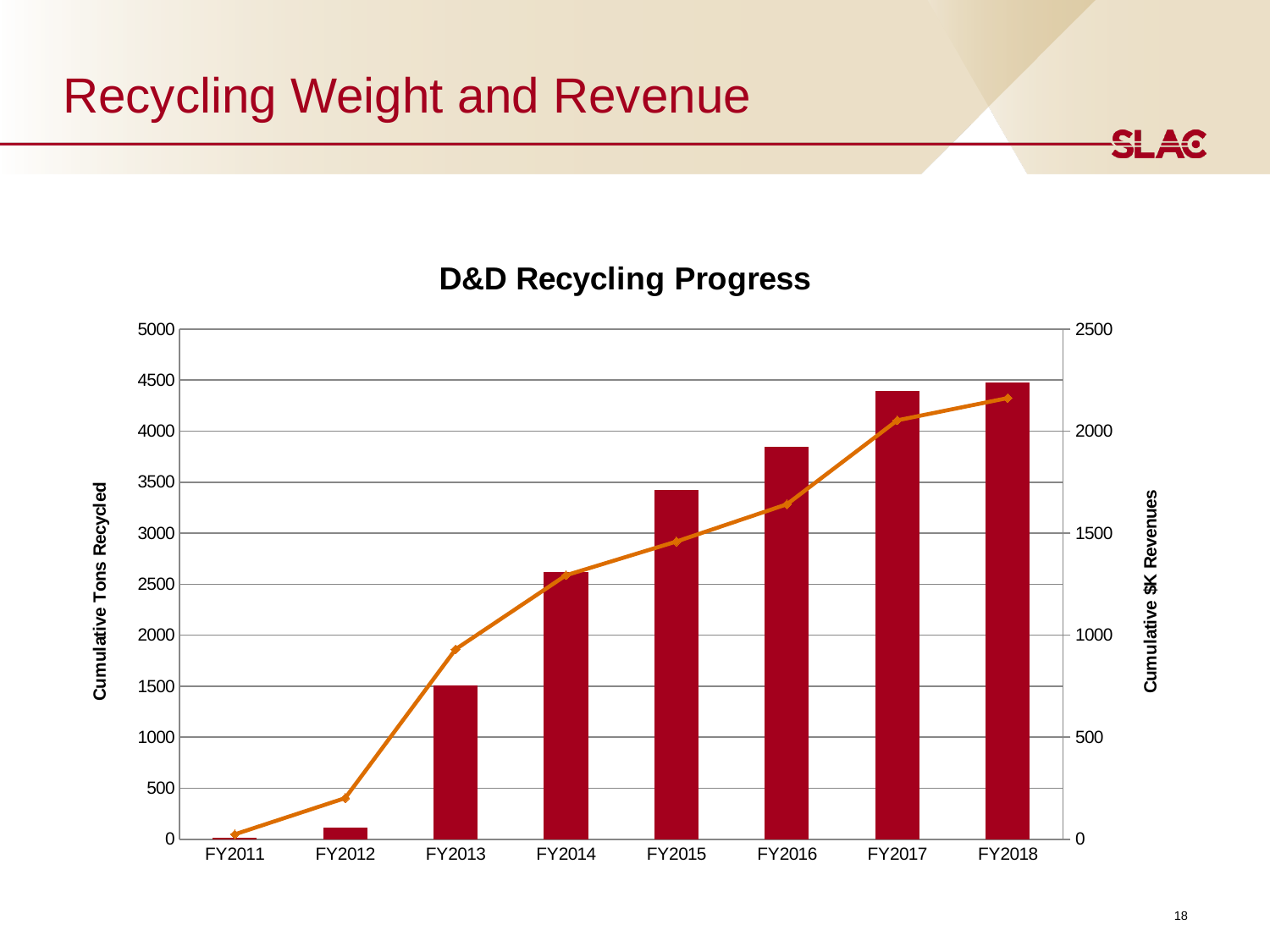
Is the cumulative $K revenues line value for FY2016 greater or less than 1500? greater Is the cumulative tons recycled bar for FY2013 greater or less than 2000? less Which has the larger cumulative tons recycled bar, FY2015 or FY2016? FY2016 Is the cumulative tons recycled bar for FY2016 greater or less than 3500? greater What is the title of the chart? D&D Recycling Progress What type of chart is shown on the slide? A combined bar and line chart How many fiscal years are shown on the x axis of the chart? 8 Which fiscal year has the shortest bar for cumulative tons recycled? FY2011 Do the cumulative tons recycled rise or fall from FY2011 to FY2018? Rise Which fiscal year has the tallest bar for cumulative tons recycled? FY2018 What is the label of the right-hand vertical axis? Cumulative $K Revenues